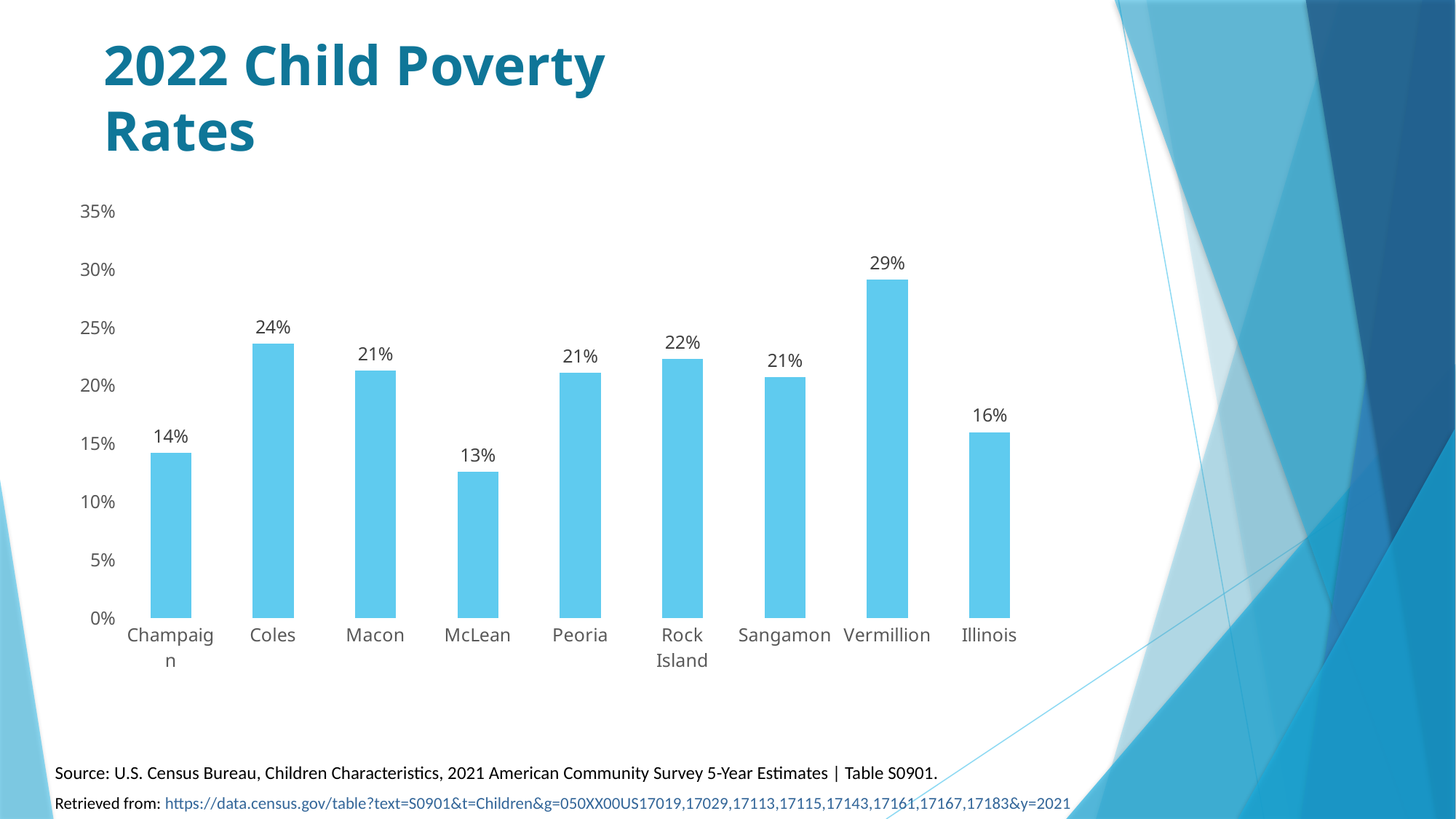
What is the difference between the child poverty rates of Coles and Illinois? 8% What kind of chart is shown on the slide? Bar chart What is the title of the slide? 2022 Child Poverty Rates Which has a higher child poverty rate, Coles or Champaign? Coles How many categories are shown on the x axis? 9 Which county has the highest child poverty rate? Vermillion What is the difference between the child poverty rates of Vermillion and McLean? 16% What is the child poverty rate for Vermillion? 29% Which county has the lowest child poverty rate? McLean What is the child poverty rate for Illinois? 16% What is the child poverty rate for Rock Island? 22% What is the child poverty rate for McLean? 13%